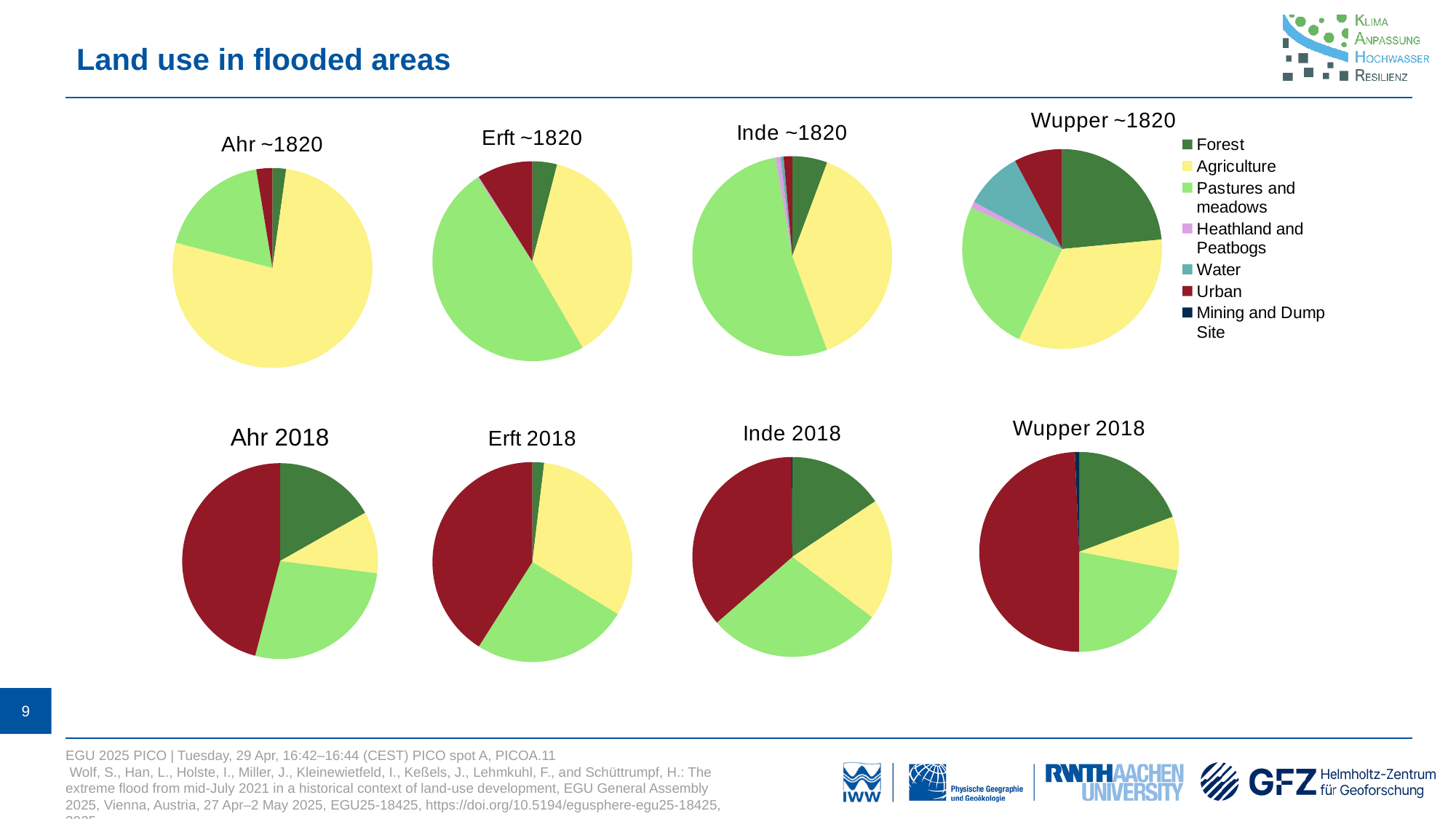
What kind of chart is used for 'Ahr ~1820'? Pie chart In the 'Ahr 2018' chart, which is larger: the Urban slice or the Forest slice? Urban In the 'Inde ~1820' chart, which land-use category has the largest share? Pastures and meadows How many land-use categories does the legend list? 7 In the 'Wupper 2018' chart, which land-use category has the largest share? Urban In the 'Ahr 2018' chart, which land-use category has the largest share? Urban How many slices does the 'Ahr 2018' pie chart have? 4 How many pie charts are shown on the slide? 8 Which colour represents Urban in the legend? Dark red In the 'Wupper ~1820' chart, which is larger: the Water slice or the Agriculture slice? Agriculture